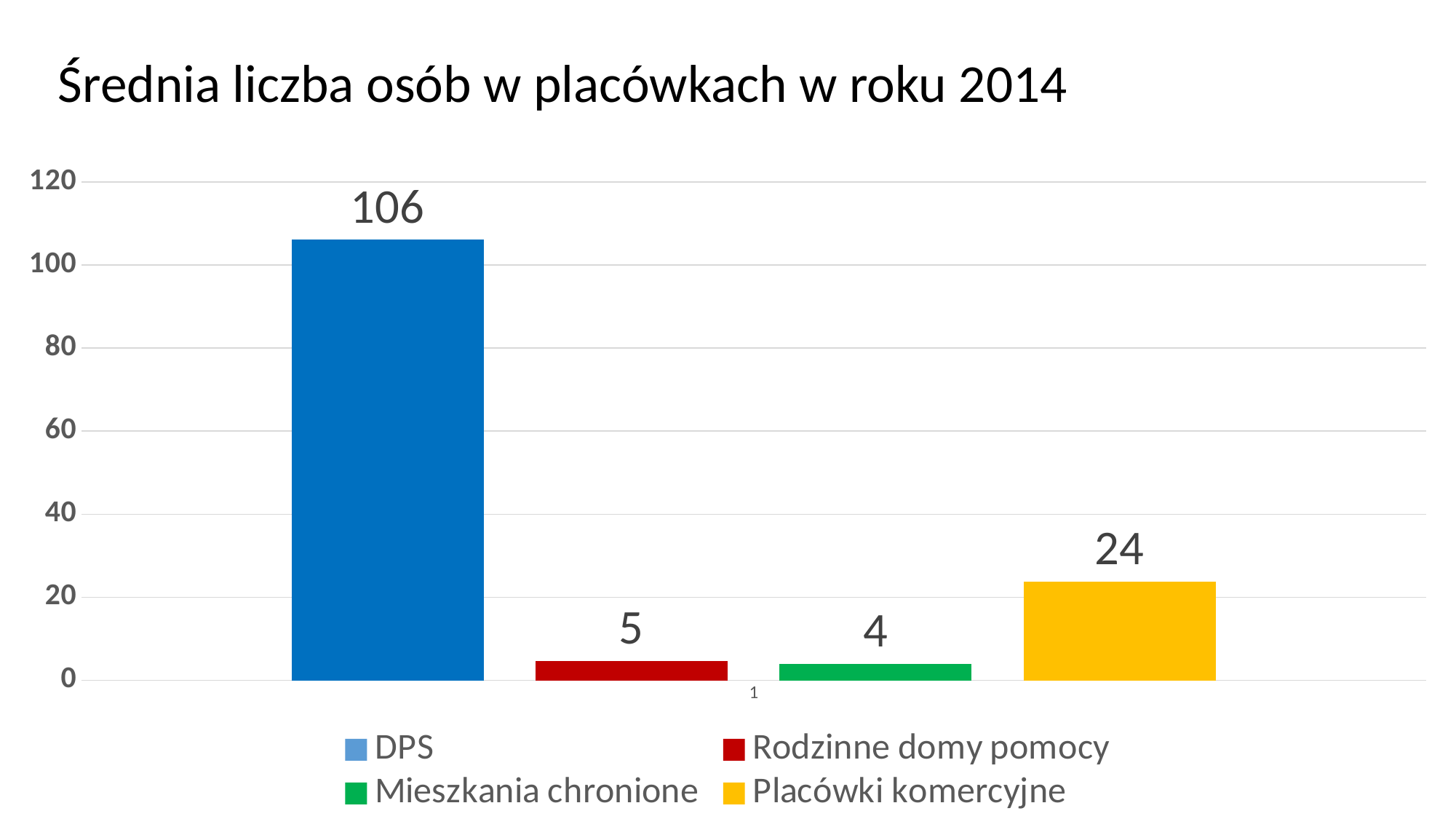
What is the value for DPS? 106 Which is larger, the value for Placówki komercyjne or the value for Rodzinne domy pomocy? Placówki komercyjne What is the difference between the values for DPS and Placówki komercyjne? 82 Which series has the lowest value? Mieszkania chronione What kind of chart is shown on the slide? Bar chart What is the title of the chart? Średnia liczba osób w placówkach w roku 2014 What is the value for Mieszkania chronione? 4 How many series does the legend list? 4 What is the value for Rodzinne domy pomocy? 5 What is the value for Placówki komercyjne? 24 What is the difference between the values for Placówki komercyjne and Rodzinne domy pomocy? 19 Which series has the highest value? DPS